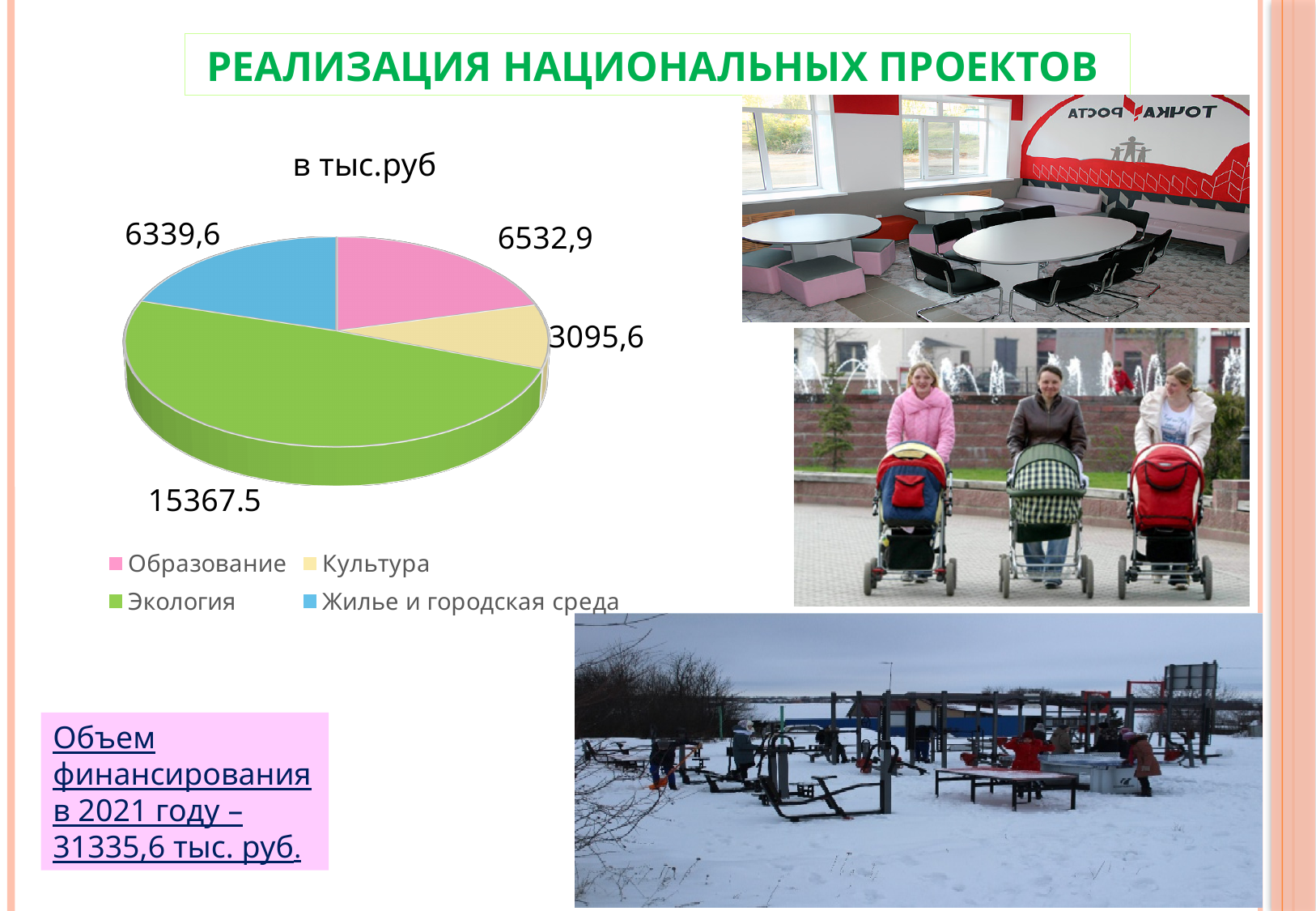
What is the difference between the values for Экология and Культура in the pie chart? 12271,9 What is the title of the pie chart? в тыс.руб What kind of chart is shown on the slide? pie chart What is the value for Культура in the pie chart? 3095,6 How many entries does the legend of the pie chart list? 4 Which category has the largest slice in the pie chart? Экология What is the value for Образование in the pie chart? 6532,9 What is the value for Экология in the pie chart? 15367.5 Which is larger in the pie chart: Образование or Жилье и городская среда? Образование What is the value for Жилье и городская среда in the pie chart? 6339,6 How many slices does the pie chart have? 4 Which category has the smallest slice in the pie chart? Культура